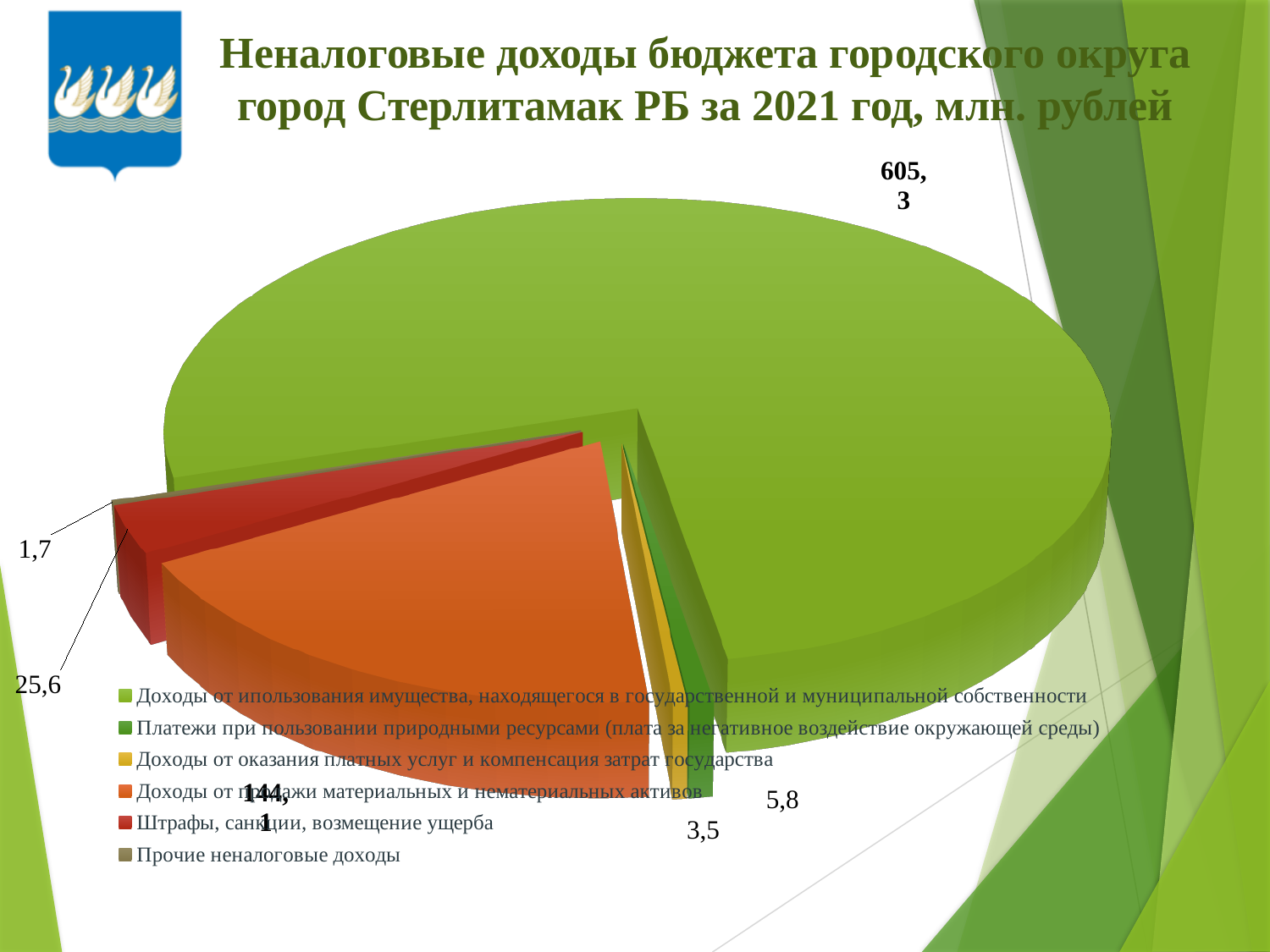
Which category has the smallest slice of the pie? Прочие неналоговые доходы What is the difference between «Штрафы, санкции, возмещение ущерба» (25,6) and «Платежи при пользовании природными ресурсами» (5,8)? 19,8 Which is larger: «Штрафы, санкции, возмещение ущерба» or «Платежи при пользовании природными ресурсами»? Штрафы, санкции, возмещение ущерба What is the value for «Прочие неналоговые доходы»? 1,7 What kind of chart is shown on the slide? pie chart What is the value for «Доходы от использования имущества, находящегося в государственной и муниципальной собственности»? 605,3 What is the value for «Штрафы, санкции, возмещение ущерба»? 25,6 How many categories does the legend of the pie chart list? 6 Which category has the largest slice of the pie? Доходы от использования имущества, находящегося в государственной и муниципальной собственности What is the value for «Платежи при пользовании природными ресурсами (плата за негативное воздействие окружающей среды)»? 5,8 What is the value for «Доходы от оказания платных услуг и компенсация затрат государства»? 3,5 What year does the chart title say the data is for? 2021